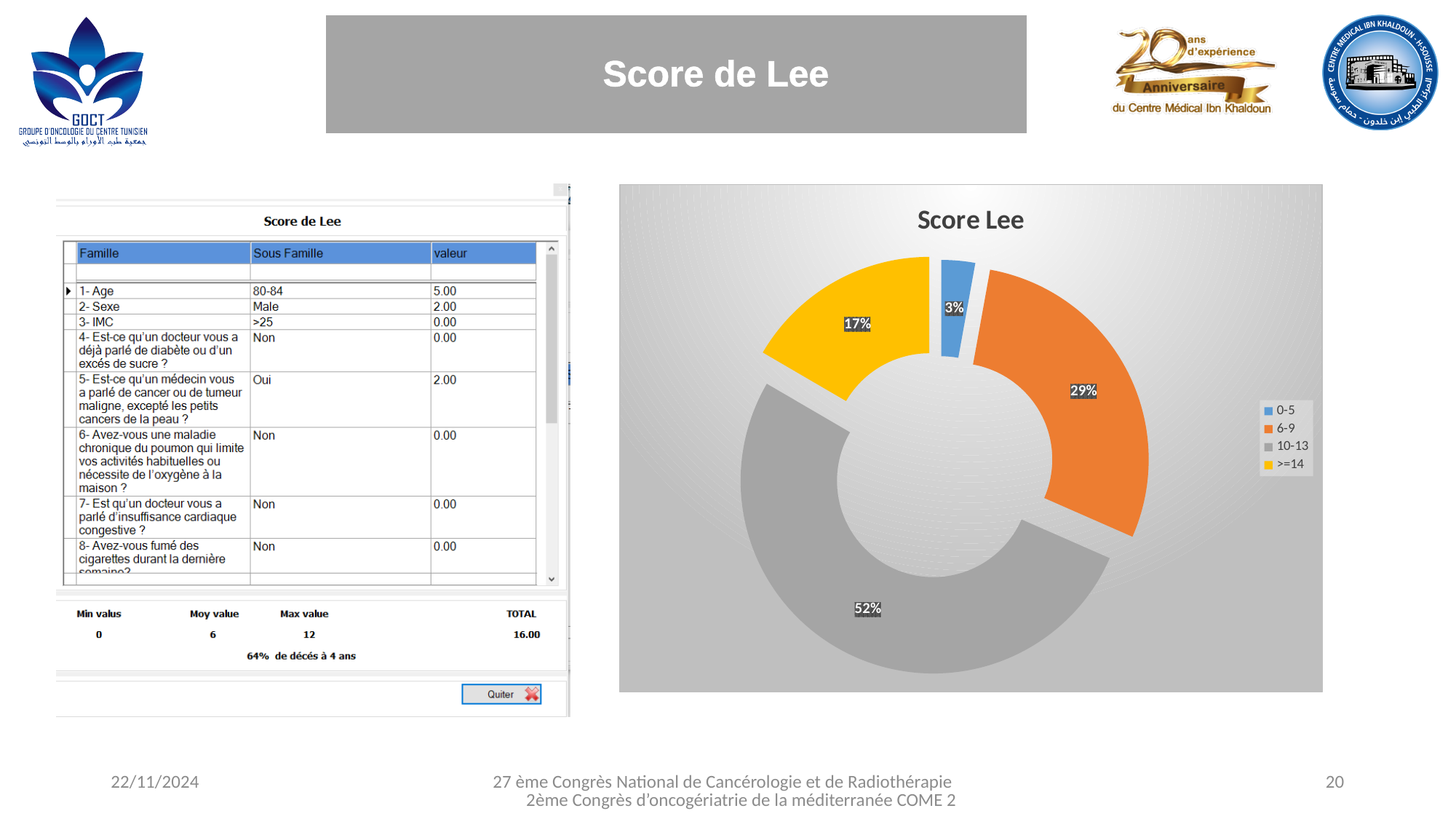
In the "Score Lee" chart, what is the difference in percentage points between the 10-13 and 6-9 categories? 23 In the "Score Lee" chart, which category has a larger share: 6-9 or >=14? 6-9 Which category has the largest share in the "Score Lee" chart? 10-13 Which category has the smallest share in the "Score Lee" chart? 0-5 In the "Score Lee" chart, what colour represents the 10-13 category? Gray In the "Score Lee" chart, what percentage is shown for the 6-9 category? 29% In the "Score Lee" chart, what percentage is shown for the >=14 category? 17% How many categories does the legend of the "Score Lee" chart list? 4 In the "Score Lee" chart, what percentage is shown for the 0-5 category? 3% What is the title of the chart on the slide? Score Lee In the "Score Lee" chart, what percentage is shown for the 10-13 category? 52% What kind of chart is the "Score Lee" chart? Doughnut chart